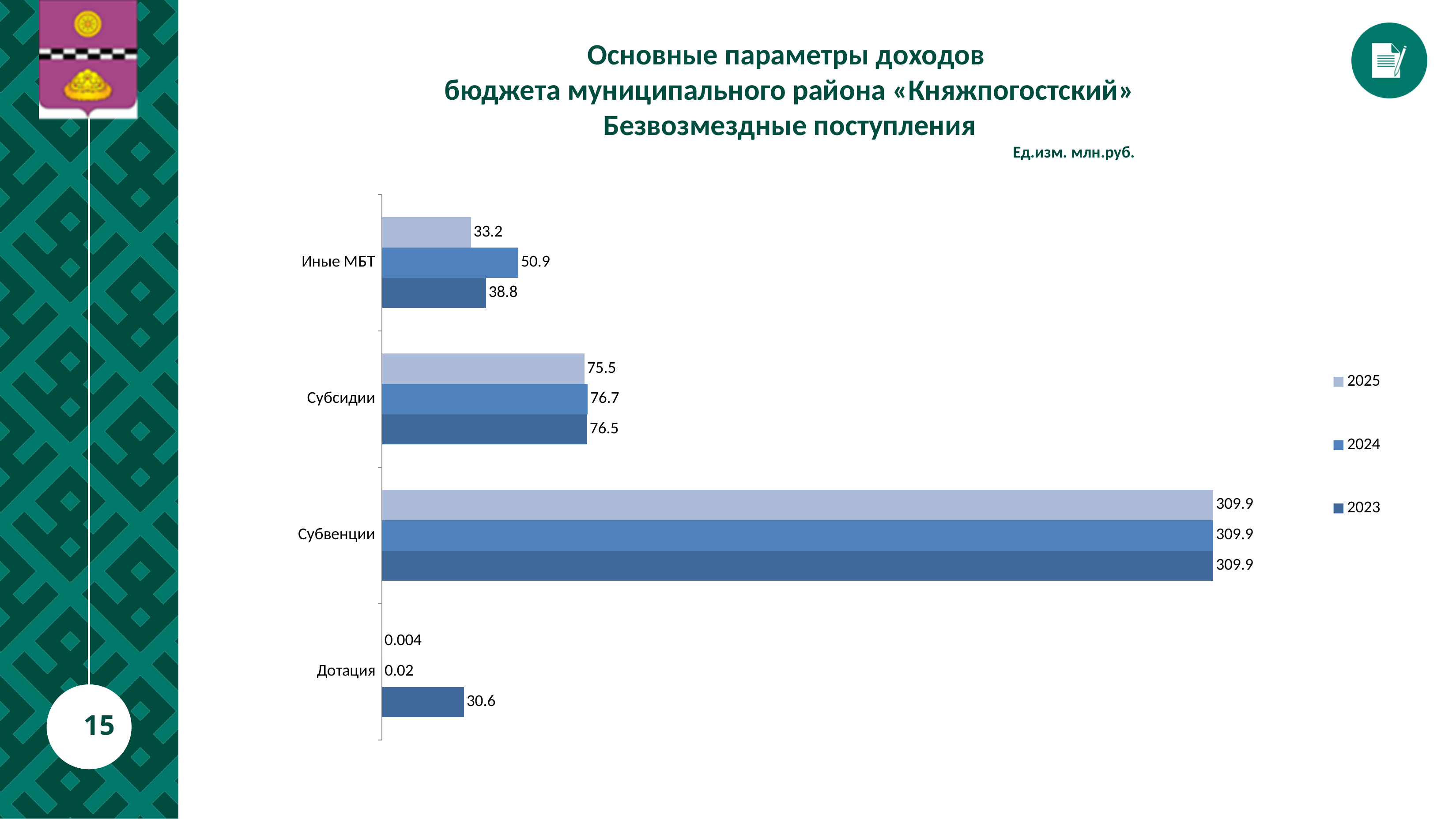
Which category has the lowest value in 2025? Дотация What is the value for Иные МБТ in 2024? 50.9 What kind of chart is shown on the slide? Bar chart What unit of measurement is stated for the chart? млн.руб. Which is larger for Иные МБТ: the 2023 value or the 2025 value? 2023 What is the value for Дотация in 2025? 0.004 What is the value for Субсидии in 2025? 75.5 How many series does the legend list? 3 What is the difference between the 2024 and 2025 values for Иные МБТ? 17.7 What is the value for Дотация in 2023? 30.6 How many categories are shown on the chart? 4 Which category has the highest value in 2024? Субвенции